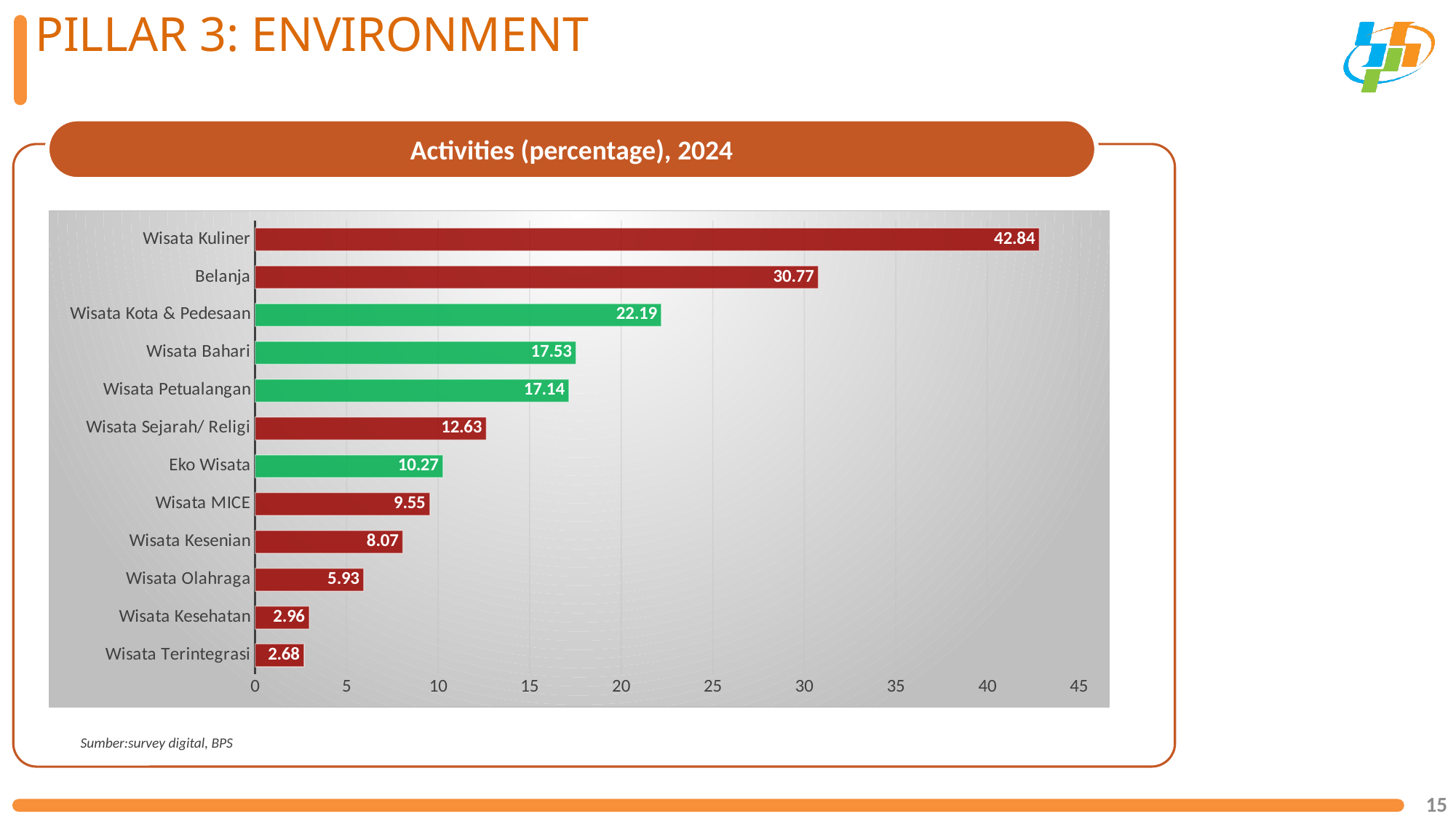
Which activity has the highest percentage? Wisata Kuliner What is the difference between the values for Wisata Kesehatan and Wisata Terintegrasi? 0.28 What is the title of the chart? Activities (percentage), 2024 What is the value for Wisata Kuliner? 42.84 What is the value for Wisata Bahari? 17.53 Which is larger, the value for Wisata Kota & Pedesaan or the value for Wisata Sejarah/ Religi? Wisata Kota & Pedesaan Which activity has the lowest percentage? Wisata Terintegrasi Is the value for Belanja greater or less than 30? greater What is the value for Eko Wisata? 10.27 What is the difference between the values for Wisata Kuliner and Belanja? 12.07 What kind of chart is shown on the slide? bar chart How many activities are shown in the chart? 12